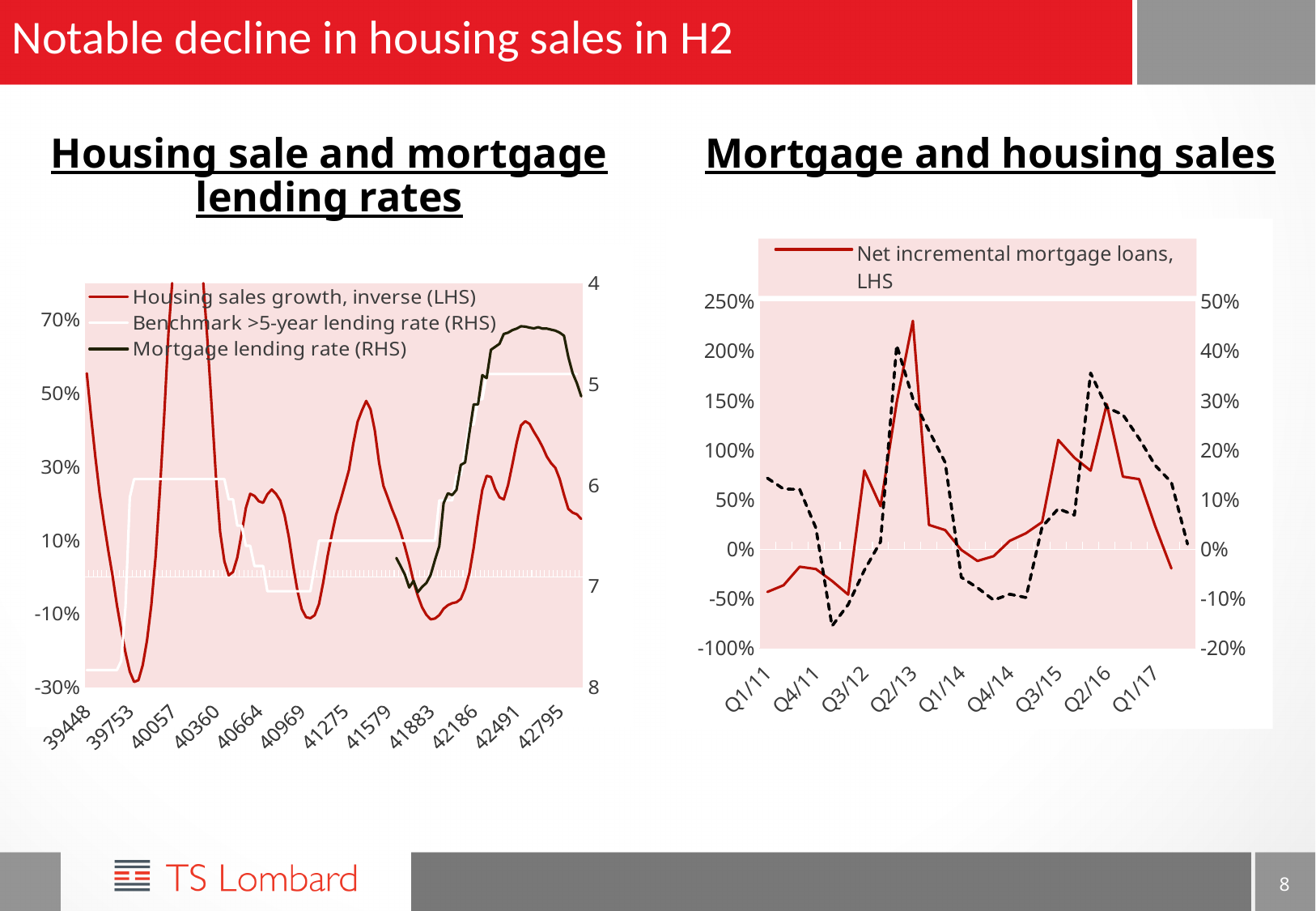
In the 'Housing sale and mortgage lending rates' chart, does the Housing sales growth line rise or fall between 42491 and 42795? Fall How many x-axis labels are shown on the 'Mortgage and housing sales' chart? 9 In the 'Housing sale and mortgage lending rates' chart, which series is plotted on the left-hand axis according to the legend? Housing sales growth, inverse (LHS) In the 'Mortgage and housing sales' chart, is the peak value of Net incremental mortgage loans around Q2/13 greater or less than 200%? greater In the 'Mortgage and housing sales' chart, does Net incremental mortgage loans rise or fall from Q2/16 to the end of the series? Fall In the 'Mortgage and housing sales' chart, is the value of Net incremental mortgage loans at the last point (after Q1/17) greater or less than 0%? less How many series does the legend of the 'Housing sale and mortgage lending rates' chart list? 3 What kind of chart is the 'Mortgage and housing sales' chart? Line chart What kind of chart is the 'Housing sale and mortgage lending rates' chart? Line chart What is the legend entry in the 'Mortgage and housing sales' chart? Net incremental mortgage loans, LHS How many x-axis labels are shown on the 'Housing sale and mortgage lending rates' chart? 12 How many series does the legend of the 'Mortgage and housing sales' chart list? 1